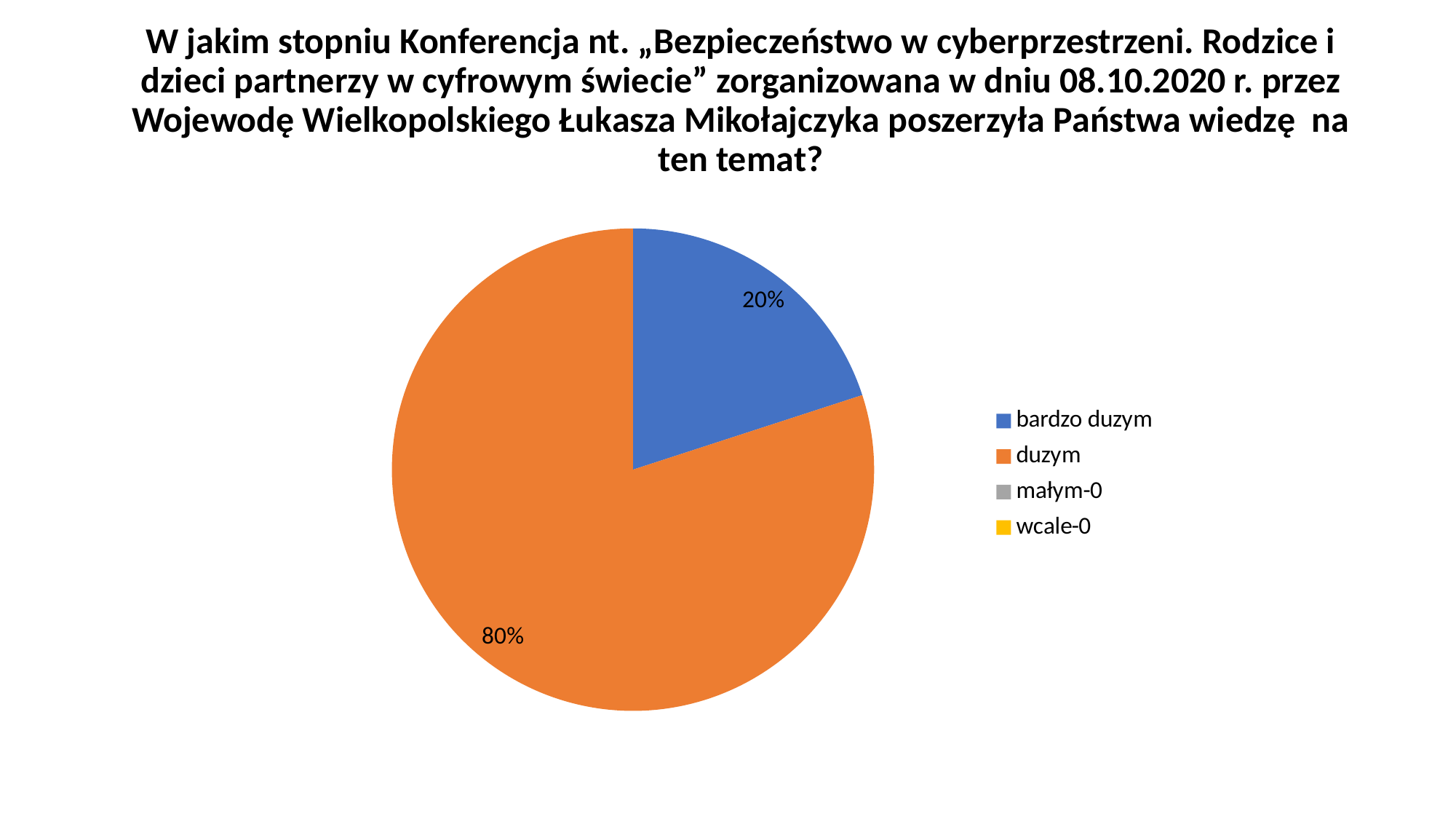
How many entries does the legend list? 4 What colour is the slice for "bardzo duzym"? blue Which is larger, the slice for "duzym" or the slice for "bardzo duzym"? duzym What kind of chart is shown on the slide? pie chart How many slices are visible in the pie? 2 What share of the pie does "bardzo duzym" take? 20% What is the difference between the share for "duzym" and the share for "bardzo duzym"? 60% What share of the pie does "duzym" take? 80% Which category has the largest slice of the pie? duzym What colour is the slice for "duzym"? orange